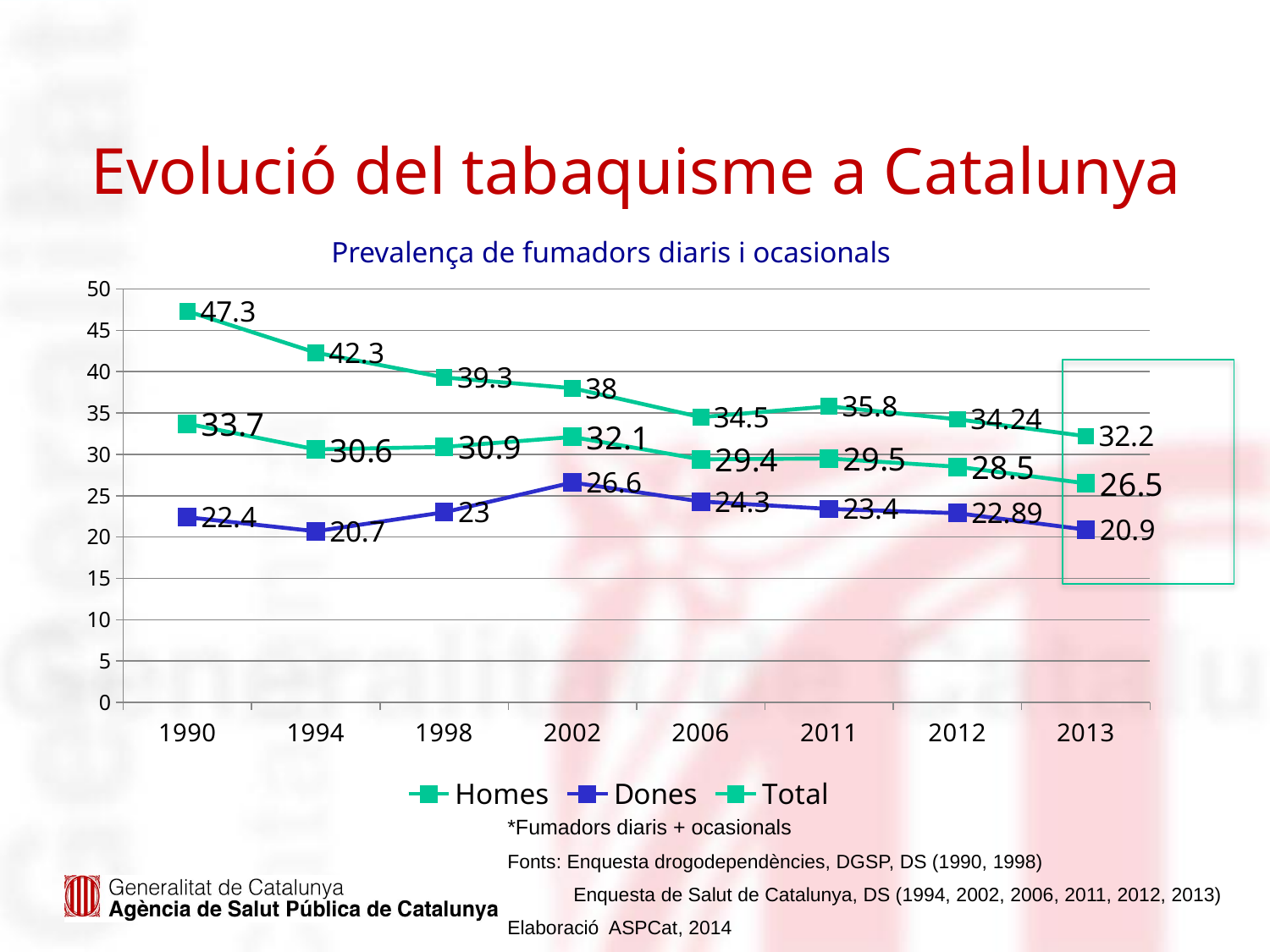
In which year is the Dones series at its highest? 2002 What is the value for Dones in 2013? 20.9 What type of chart is shown on the slide? line chart Which is larger, the Total value in 1990 or the Total value in 2013? 1990 What is the difference between the Homes value and the Dones value in 2013? 11.3 How many series does the legend list? 3 What is the value for Total in 2002? 32.1 What is the value for Homes in 1990? 47.3 What is the subtitle of the chart? Prevalença de fumadors diaris i ocasionals Does the Homes series generally rise or fall from 1990 to 2013? fall How many years are shown on the x axis? 8 In which year is the Homes series at its lowest? 2013